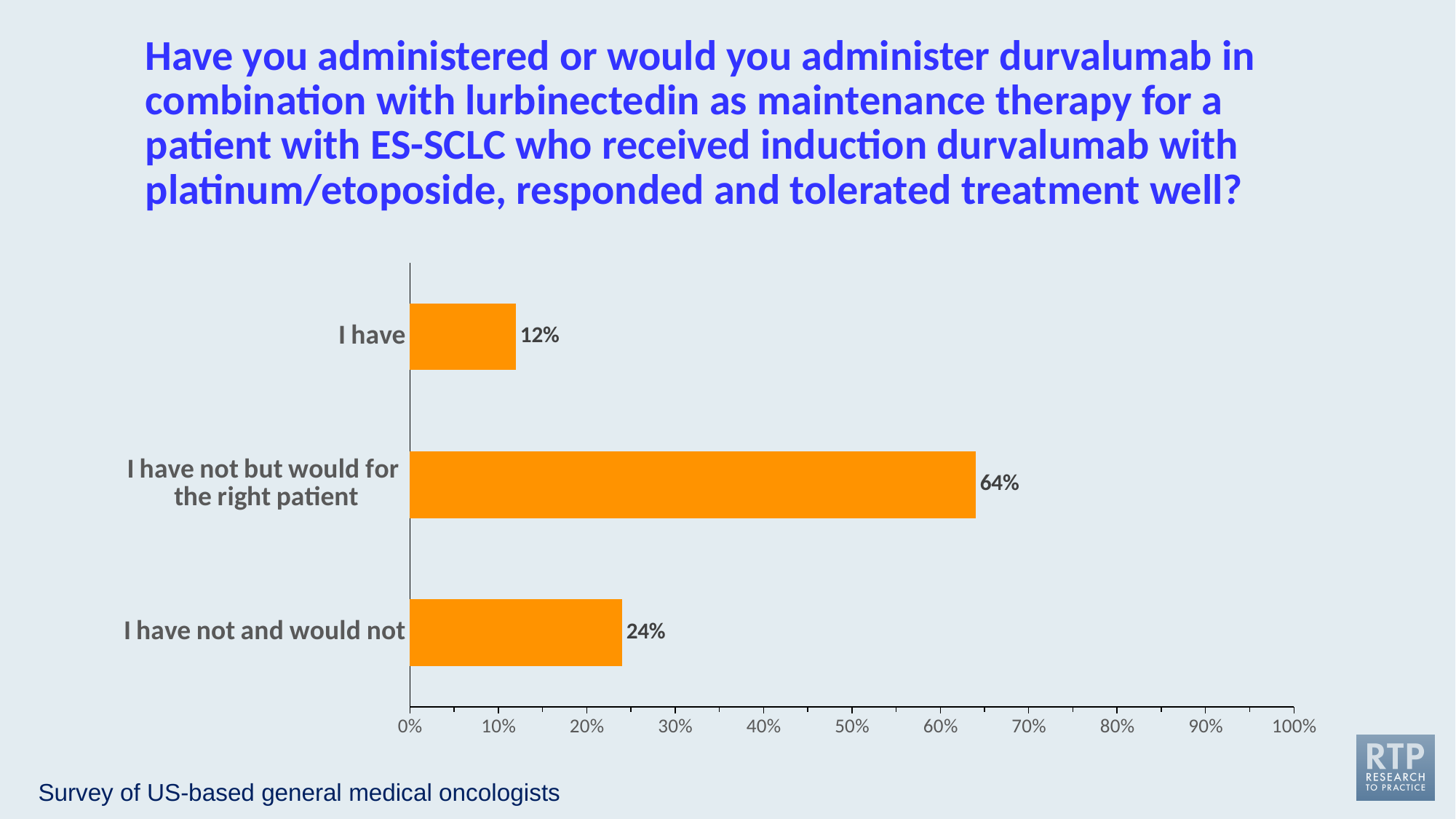
What percentage of respondents answered "I have"? 12% How many response categories are shown in the chart? 3 Is the value for "I have not but would for the right patient" greater or less than 50%? greater Which response category has the highest percentage? I have not but would for the right patient What type of chart is shown on the slide? Bar chart What is the maximum value shown on the horizontal axis? 100% Which response category has the lowest percentage? I have What is the difference in percentage points between "I have not and would not" and "I have"? 12 What percentage of respondents answered "I have not and would not"? 24% What is the difference in percentage points between "I have not but would for the right patient" and "I have not and would not"? 40 Which is larger: the value for "I have not and would not" or the value for "I have"? I have not and would not What percentage of respondents answered "I have not but would for the right patient"? 64%